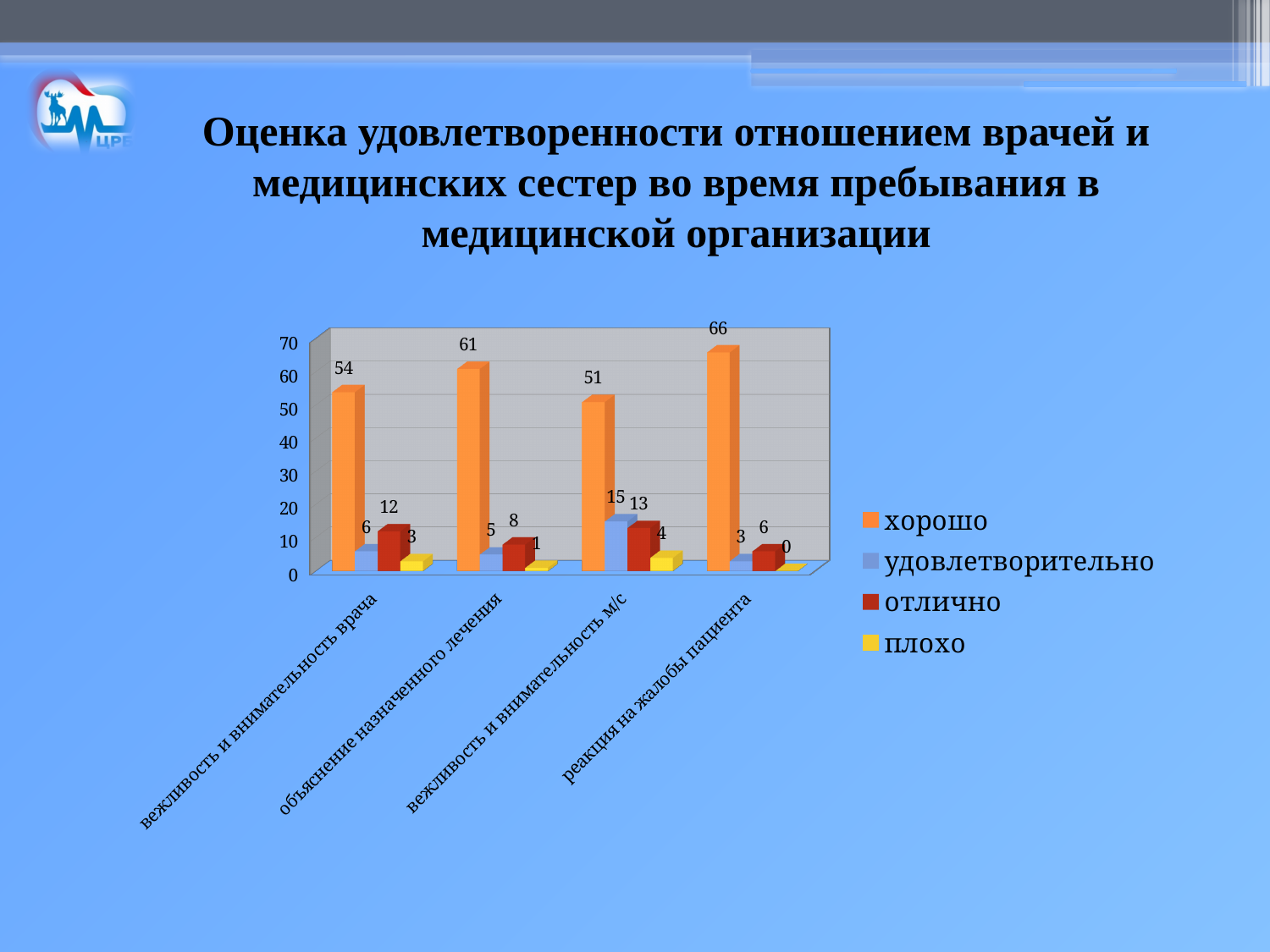
How many categories are shown on the x axis? 4 Which is larger: "удовлетворительно" for "вежливость и внимательность м/с" or "отлично" for "вежливость и внимательность врача"? удовлетворительно for вежливость и внимательность м/с Which category has the highest value for "хорошо"? реакция на жалобы пациента How many series does the legend list? 4 What is the value of "хорошо" for "реакция на жалобы пациента"? 66 What is the value of "плохо" for "вежливость и внимательность врача"? 3 What is the value of "отлично" for "вежливость и внимательность м/с"? 13 Which category has the lowest value for "хорошо"? вежливость и внимательность м/с What is the value of "удовлетворительно" for "объяснение назначенного лечения"? 5 Which series is shown in yellow in the legend? плохо What kind of chart is shown on the slide? bar chart What is the difference between the "хорошо" values for "реакция на жалобы пациента" and "вежливость и внимательность врача"? 12